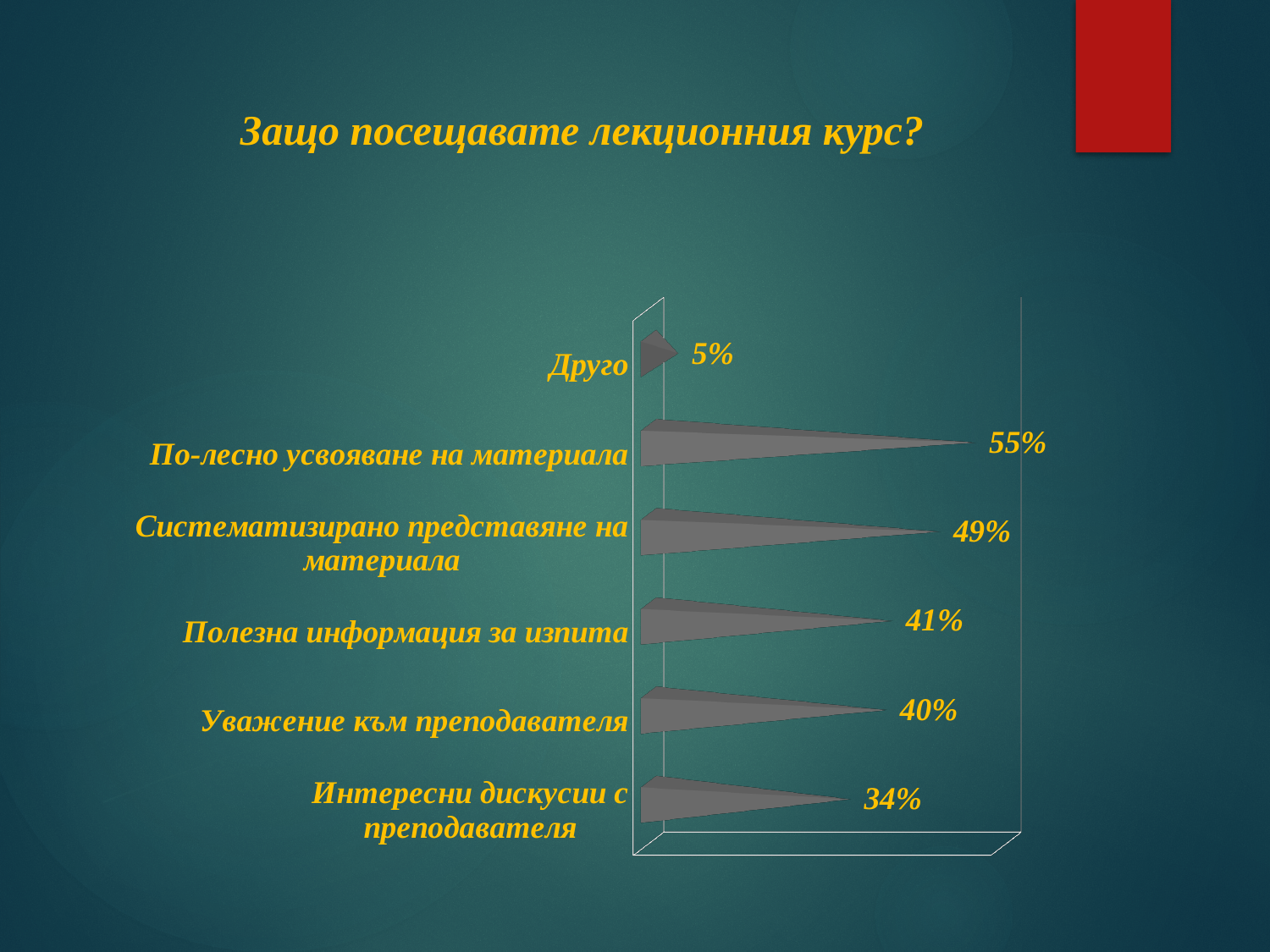
What is the title of the slide? Защо посещавате лекционния курс? What kind of chart is shown on the slide? Bar chart How many categories are shown in the chart? 6 What is the difference between the values for "По-лесно усвояване на материала" and "Систематизирано представяне на материала"? 6% Which category has the lowest value? Друго What is the difference between the values for "Полезна информация за изпита" and "Интересни дискусии с преподавателя"? 7% What is the value for "Уважение към преподавателя"? 40% Which category has the highest value? По-лесно усвояване на материала What is the value for "Интересни дискусии с преподавателя"? 34% What is the value for "По-лесно усвояване на материала"? 55% Which is larger: the value for "Систематизирано представяне на материала" or for "Уважение към преподавателя"? Систематизирано представяне на материала What is the value for "Друго"? 5%